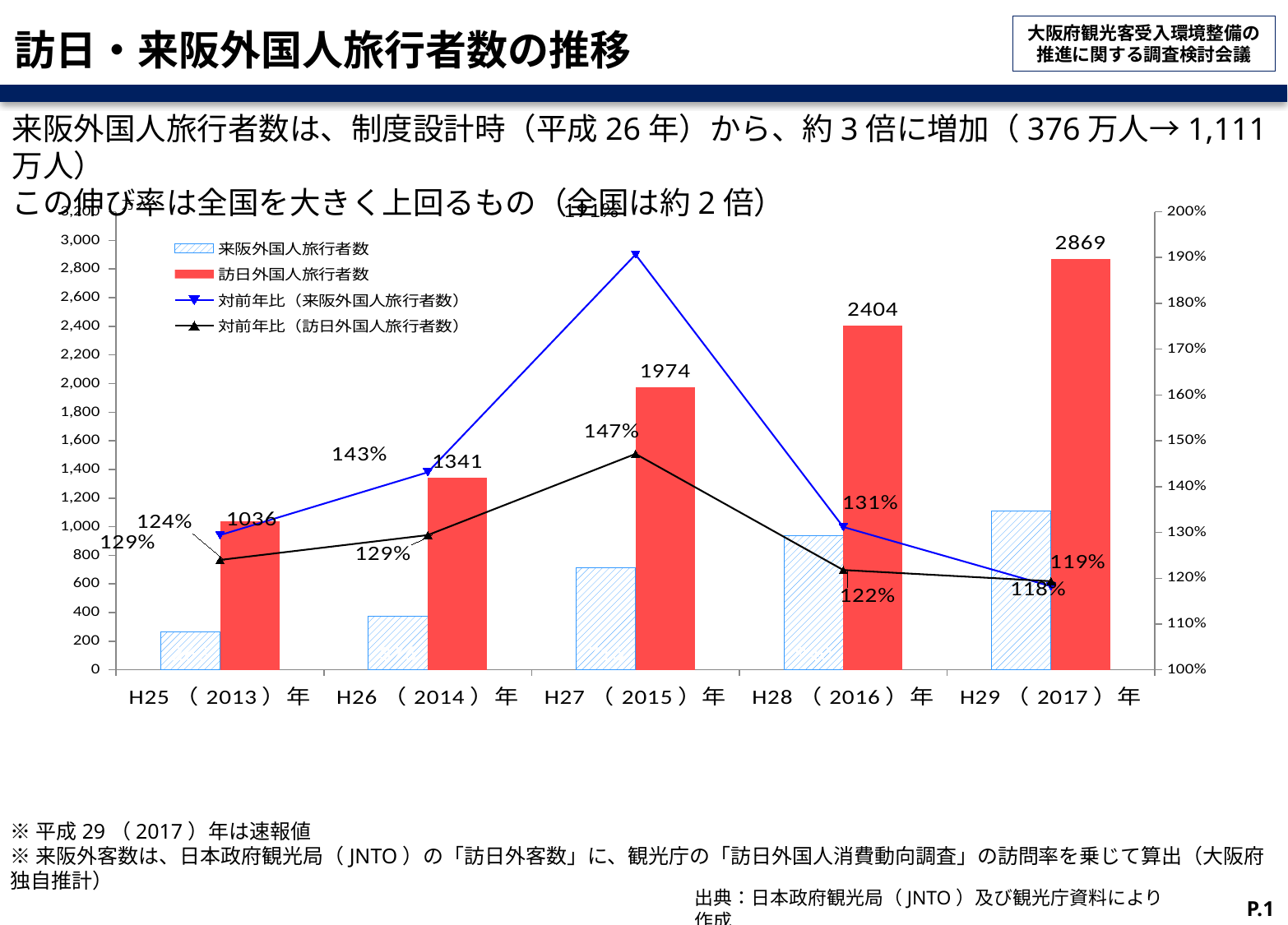
What is the value of 訪日外国人旅行者数 for H29（2017）年? 2869 What is the 対前年比（来阪外国人旅行者数） value for H26（2014）年? 143% What is the difference in 訪日外国人旅行者数 between H28（2016）年 and H27（2015）年? 430 Which year has the highest 訪日外国人旅行者数? H29（2017）年 Which is larger in H26（2014）年: 対前年比（来阪外国人旅行者数） or 対前年比（訪日外国人旅行者数）? 対前年比（来阪外国人旅行者数） What is the 対前年比（訪日外国人旅行者数） value for H27（2015）年? 147% Does 訪日外国人旅行者数 rise or fall from H25（2013）年 to H29（2017）年? rise Which year has the lowest 対前年比（来阪外国人旅行者数）? H29（2017）年 What is the value of 訪日外国人旅行者数 for H25（2013）年? 1036 Is the value of 来阪外国人旅行者数 for H25（2013）年 greater or less than 400? less Is the value of 来阪外国人旅行者数 for H29（2017）年 greater or less than 1,000? greater How many series does the legend list? 4